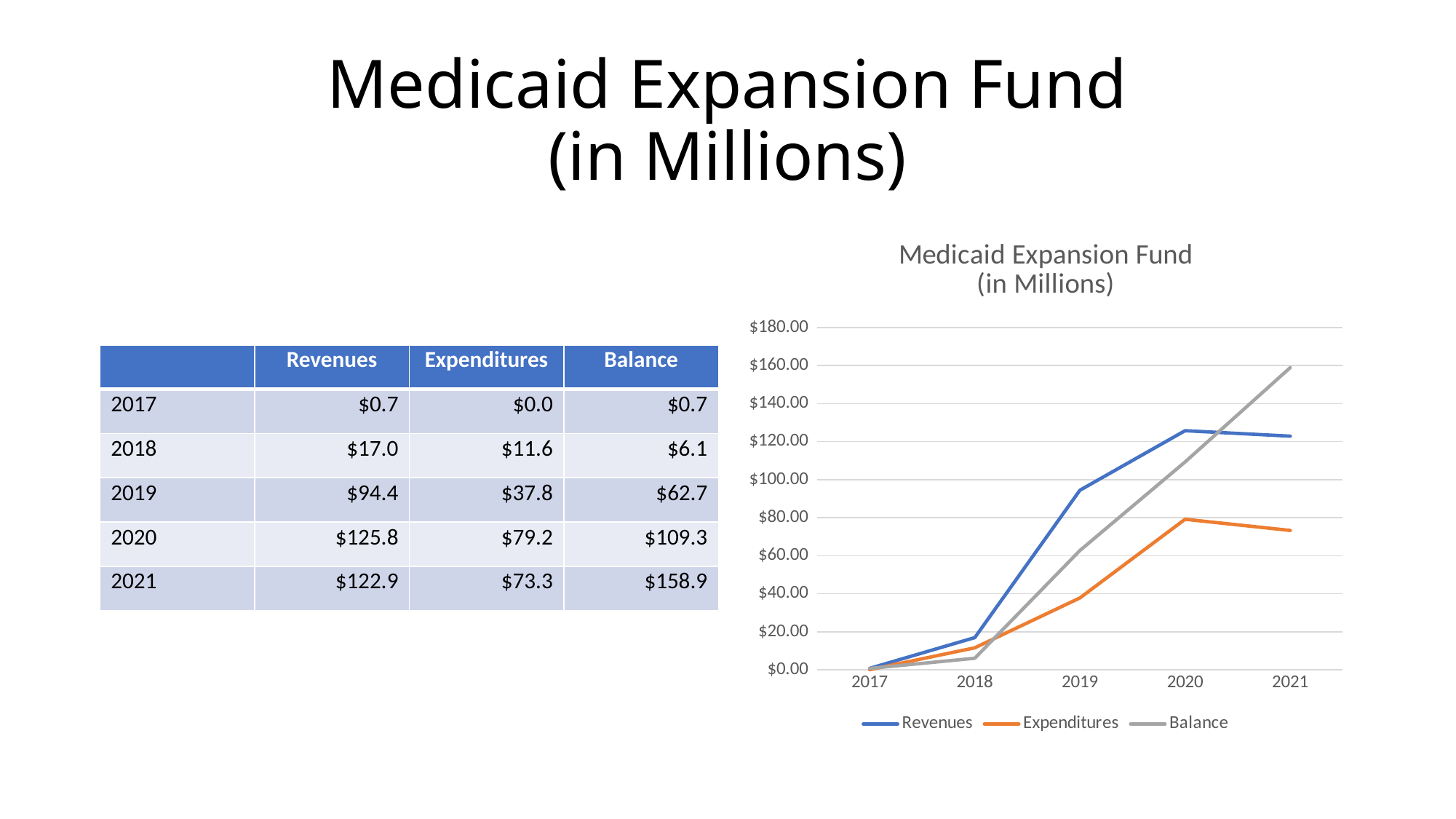
What is the Balance value for 2021? $158.9 In which year are Revenues lowest? 2017 Is the Balance value for 2020 greater or less than $100.00? greater Do Expenditures rise or fall from 2020 to 2021? fall What is the difference between Revenues and Expenditures in 2019? $56.6 What is the Revenues value for 2020? $125.8 Which series is drawn in orange on the chart? Expenditures How many years are plotted along the x axis of the chart? 5 What kind of chart is shown on the slide? line chart What is the title of the chart? Medicaid Expansion Fund (in Millions) How many series does the chart's legend list? 3 In which year is the Balance highest? 2021